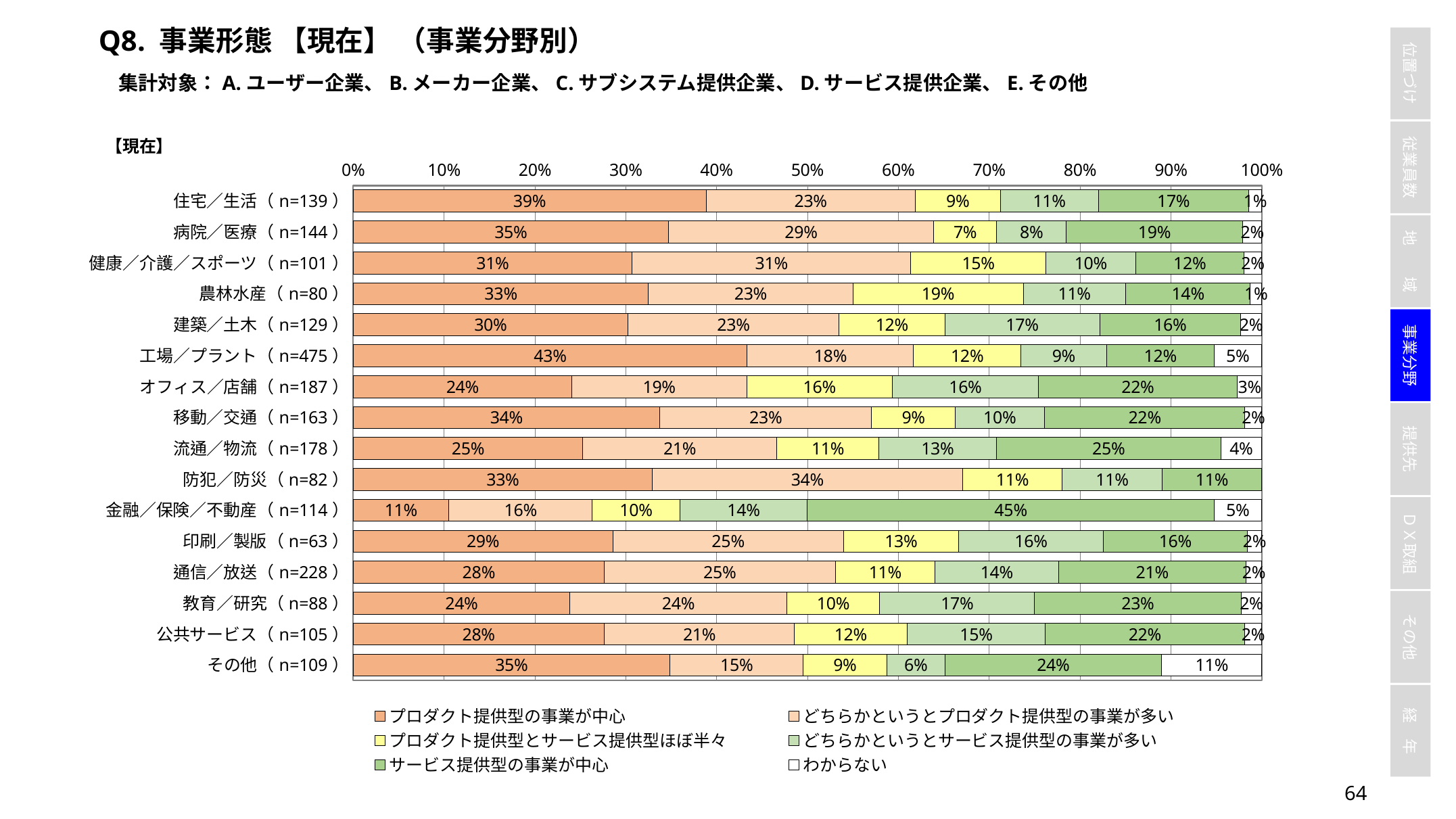
Which category has the lowest share for プロダクト提供型の事業が中心? 金融／保険／不動産 What kind of chart is shown on the slide? Stacked bar chart What percentage of 工場／プラント respondents answered プロダクト提供型の事業が中心? 43% What percentage of 金融／保険／不動産 respondents answered サービス提供型の事業が中心? 45% What percentage of その他 respondents answered わからない? 11% How many series does the legend list? 6 What is the sample size (n) shown for 工場／プラント? 475 Which category has the highest share for プロダクト提供型の事業が中心? 工場／プラント How many business-field categories are shown in the chart? 16 Which category has the highest share for サービス提供型の事業が中心? 金融／保険／不動産 What is the difference in percentage points between 工場／プラント and 金融／保険／不動産 for プロダクト提供型の事業が中心? 32 percentage points Which has a larger share for どちらかというとプロダクト提供型の事業が多い, 病院／医療 or 住宅／生活? 病院／医療